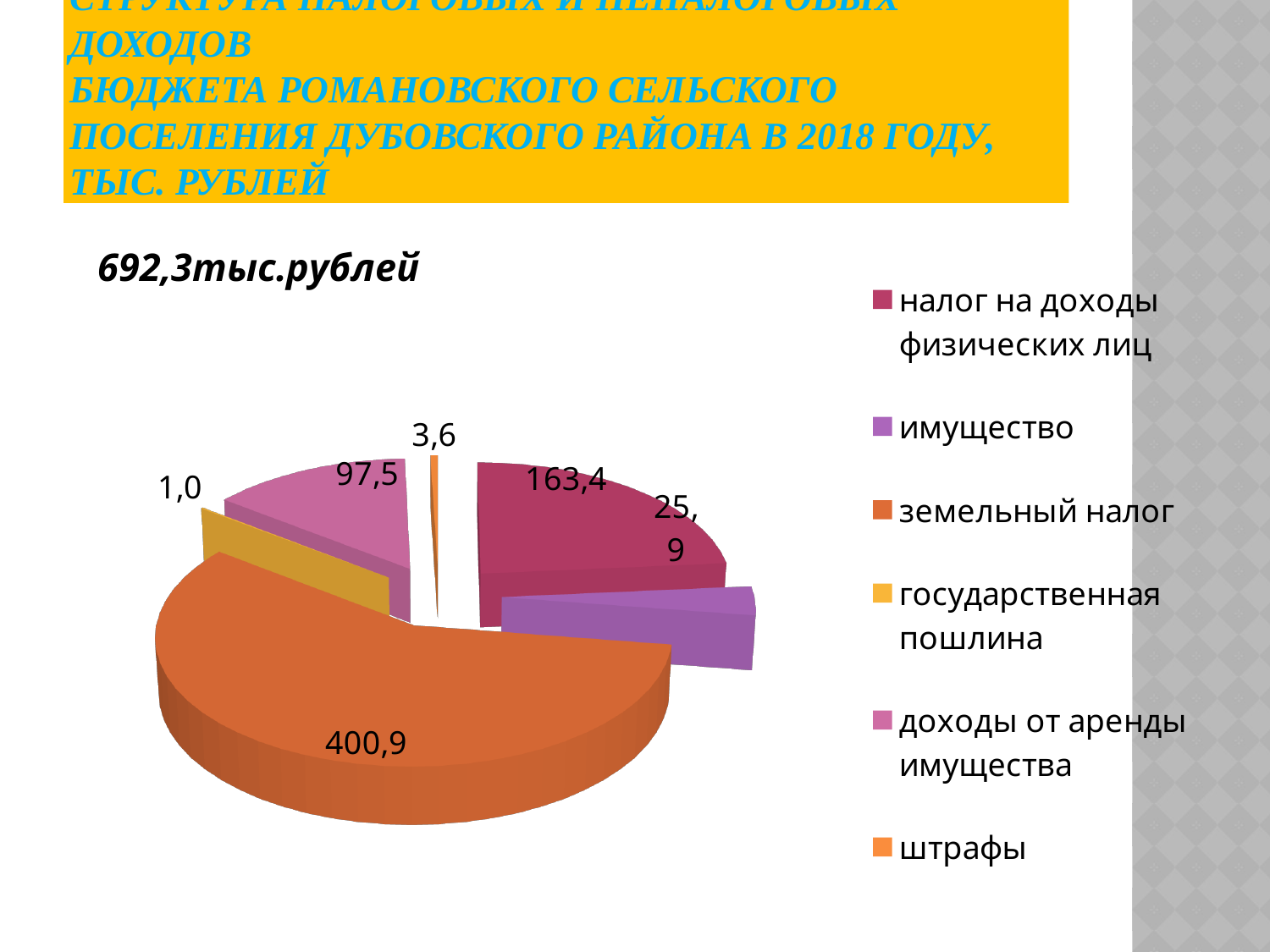
Which is larger: имущество or доходы от аренды имущества? доходы от аренды имущества What value is shown for доходы от аренды имущества? 97,5 How many categories does the pie chart show? 6 Which category has the smallest slice of the pie? государственная пошлина What total amount in тыс. рублей is stated above the chart? 692,3тыс.рублей What is the difference between the values for земельный налог and налог на доходы физических лиц? 237,5 What value is shown for налог на доходы физических лиц? 163,4 Which category has the largest slice of the pie? земельный налог What kind of chart is shown on the slide? pie chart What value is shown for земельный налог on the pie chart? 400,9 What colour is the slice for земельный налог? orange What value is shown for штрафы? 3,6